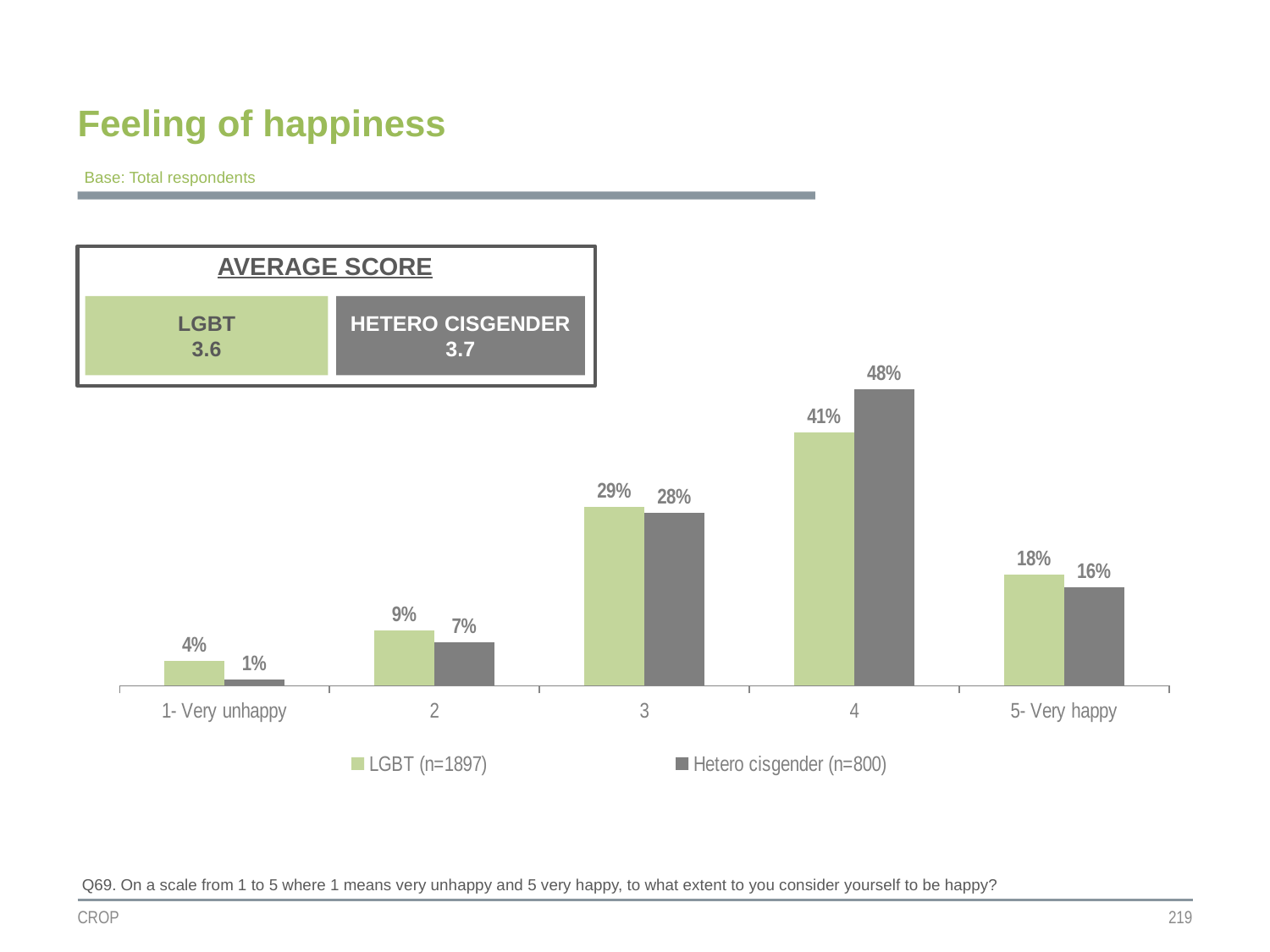
Which category has the lowest value for LGBT (n=1897)? 1- Very unhappy What kind of chart is shown on the slide? Bar chart What is the value for LGBT (n=1897) at category 4? 41% Which category has the highest value for Hetero cisgender (n=800)? 4 What is the average score shown for Hetero cisgender in the box above the chart? 3.7 How many series does the legend list? 2 How many categories are shown on the x axis? 5 What is the value for LGBT (n=1897) at category 5- Very happy? 18% What is the difference between the Hetero cisgender (n=800) and LGBT (n=1897) values at category 4? 7% What is the title of the slide? Feeling of happiness What is the value for Hetero cisgender (n=800) at category 1- Very unhappy? 1% At category 2, which series has the larger value, LGBT (n=1897) or Hetero cisgender (n=800)? LGBT (n=1897)